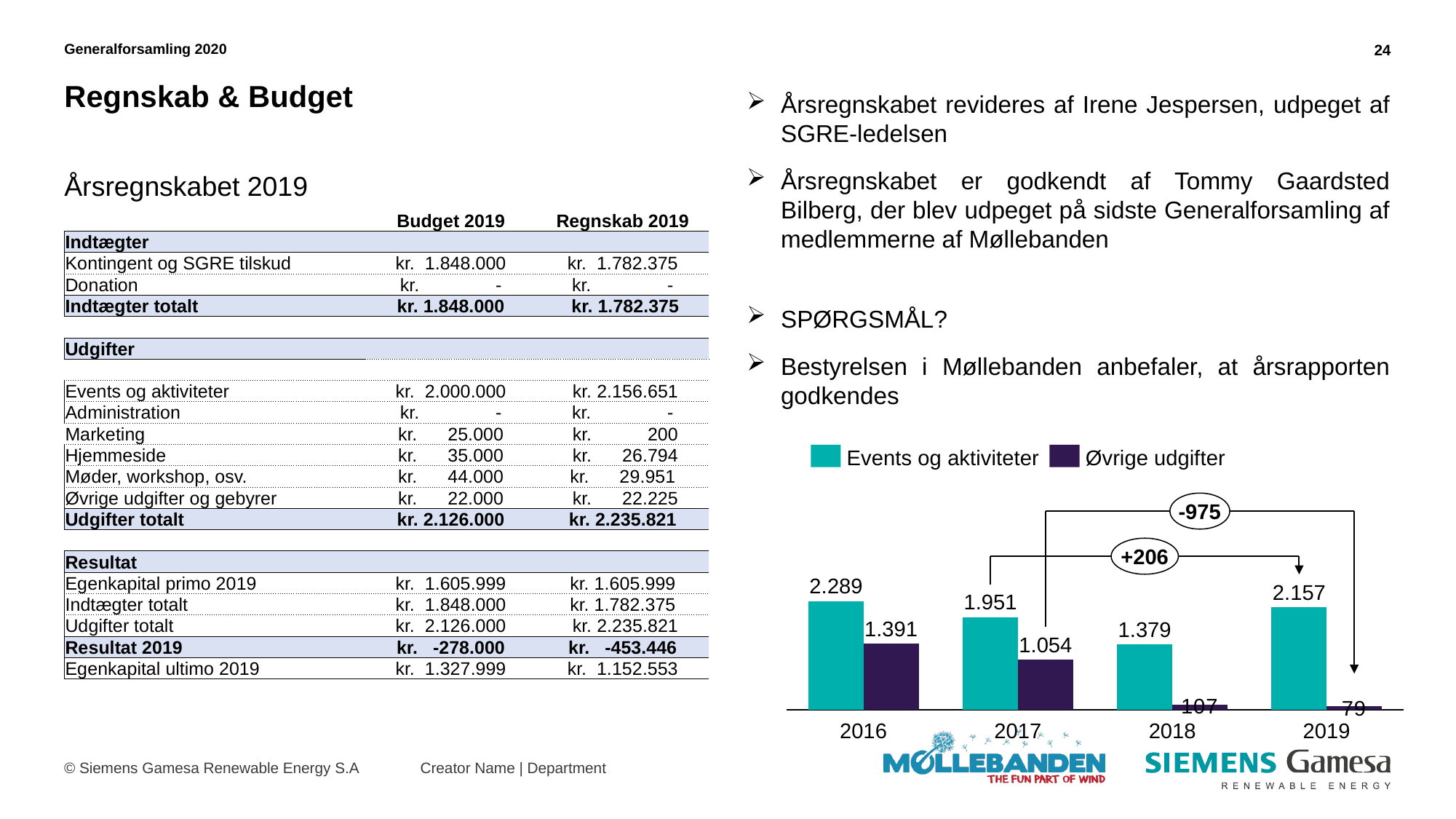
Do the values for Øvrige udgifter rise or fall from 2016 to 2019? Fall How many series does the chart legend list? 2 What is the value for Events og aktiviteter in 2016? 2.289 What is the value for Øvrige udgifter in 2017? 1.054 What kind of chart is shown on the slide? Bar chart In which year is Events og aktiviteter highest? 2016 What is the value for Øvrige udgifter in 2019? 79 In which year is Øvrige udgifter lowest? 2019 What is the difference between Events og aktiviteter in 2016 and in 2017? 338 How many years are shown on the x axis of the chart? 4 Which is larger: Events og aktiviteter in 2019 or Events og aktiviteter in 2018? Events og aktiviteter in 2019 What is the value for Events og aktiviteter in 2018? 1.379